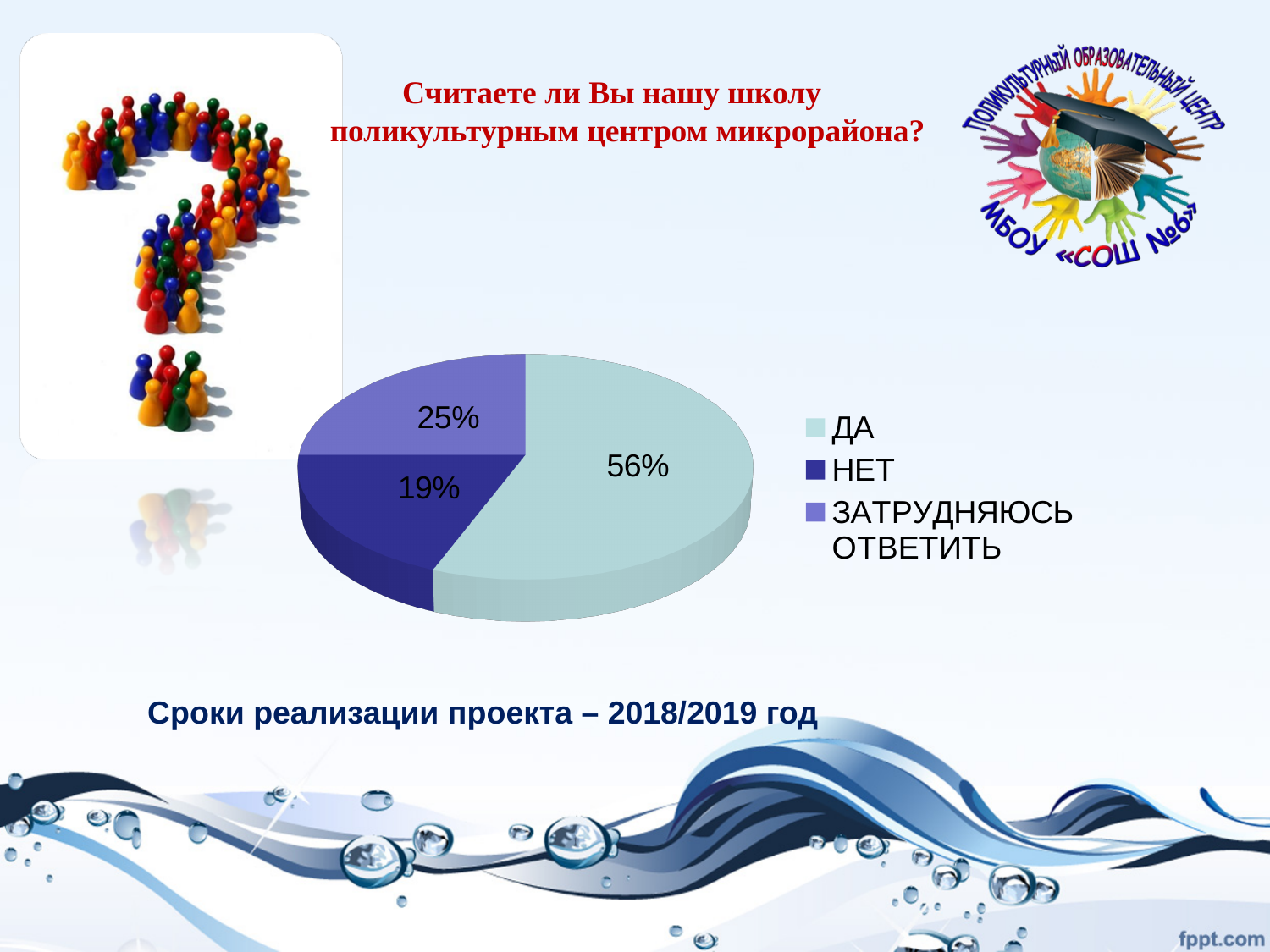
What share of the pie does НЕТ have? 19% What is the difference in percentage points between ДА and НЕТ? 37 How many slices does the pie chart have? 3 What kind of chart is shown on the slide? pie chart What share of the pie does ДА have? 56% Which category has the largest slice of the pie? ДА What is the difference in percentage points between ЗАТРУДНЯЮСЬ ОТВЕТИТЬ and НЕТ? 6 Which is larger, the slice for ЗАТРУДНЯЮСЬ ОТВЕТИТЬ or the slice for НЕТ? ЗАТРУДНЯЮСЬ ОТВЕТИТЬ Which category has the smallest slice of the pie? НЕТ What colour is the slice for ДА? light blue What share of the pie does ЗАТРУДНЯЮСЬ ОТВЕТИТЬ have? 25% How many entries does the legend list? 3